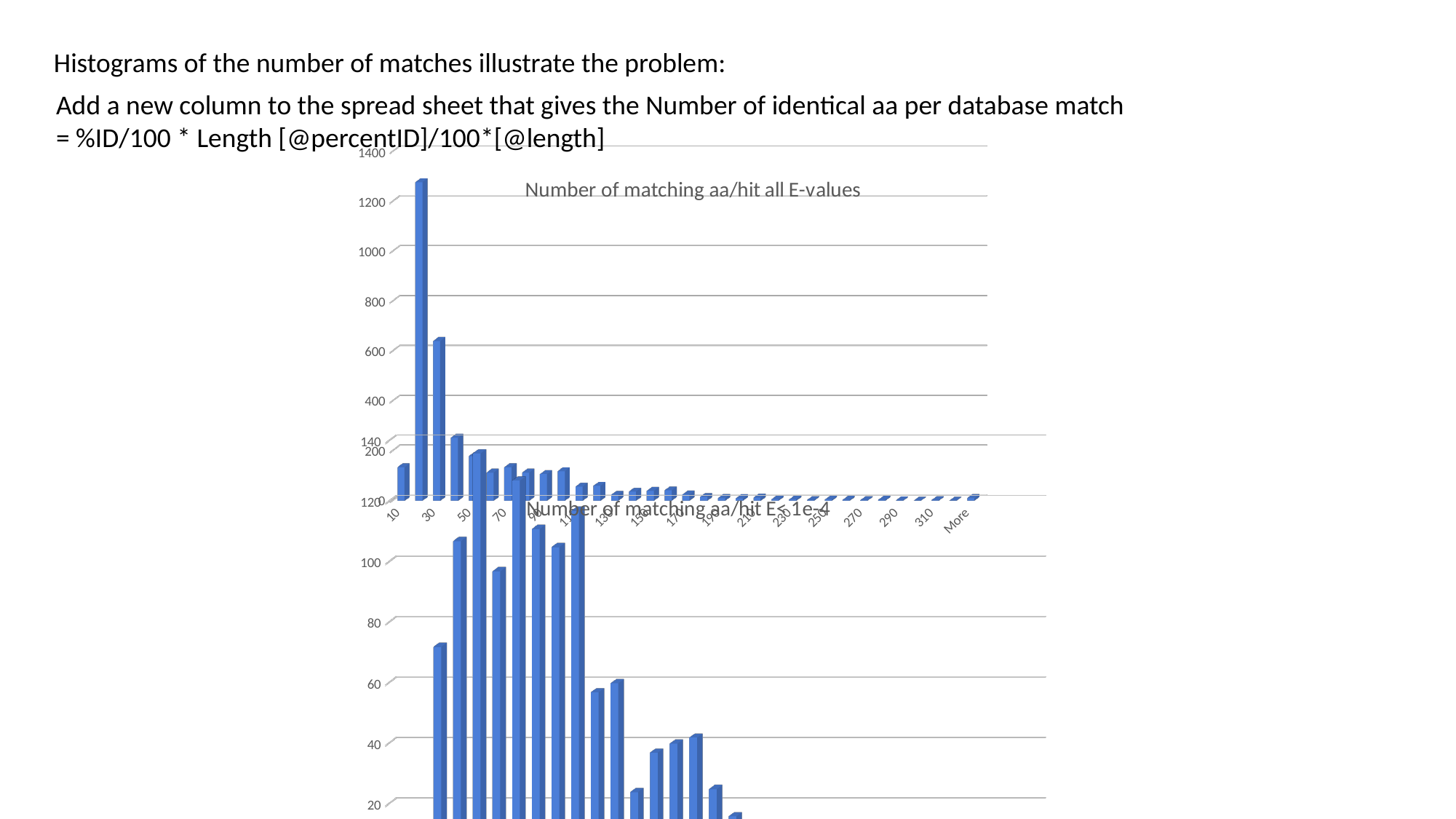
In the chart 'Number of matching aa/hit all E-values', which has the larger value, 10 or 50? 50 In the chart 'Number of matching aa/hit all E-values', is the value for 50 greater or less than 400? less In the chart 'Number of matching aa/hit all E-values', is the value for 270 greater or less than 200? less In the chart 'Number of matching aa/hit all E-values', is the value for 10 greater or less than 400? less What kind of chart is the top chart titled 'Number of matching aa/hit all E-values'? bar chart In the chart 'Number of matching aa/hit all E-values', do the values generally rise or fall along the x axis from 30 to 310? fall What is the title of the lower chart on the slide? Number of matching aa/hit E<1e-4 In the chart 'Number of matching aa/hit all E-values', which has the larger value, 30 or 50? 30 What kind of chart is the lower chart titled 'Number of matching aa/hit E<1e-4'? bar chart What is the title of the top chart on the slide? Number of matching aa/hit all E-values